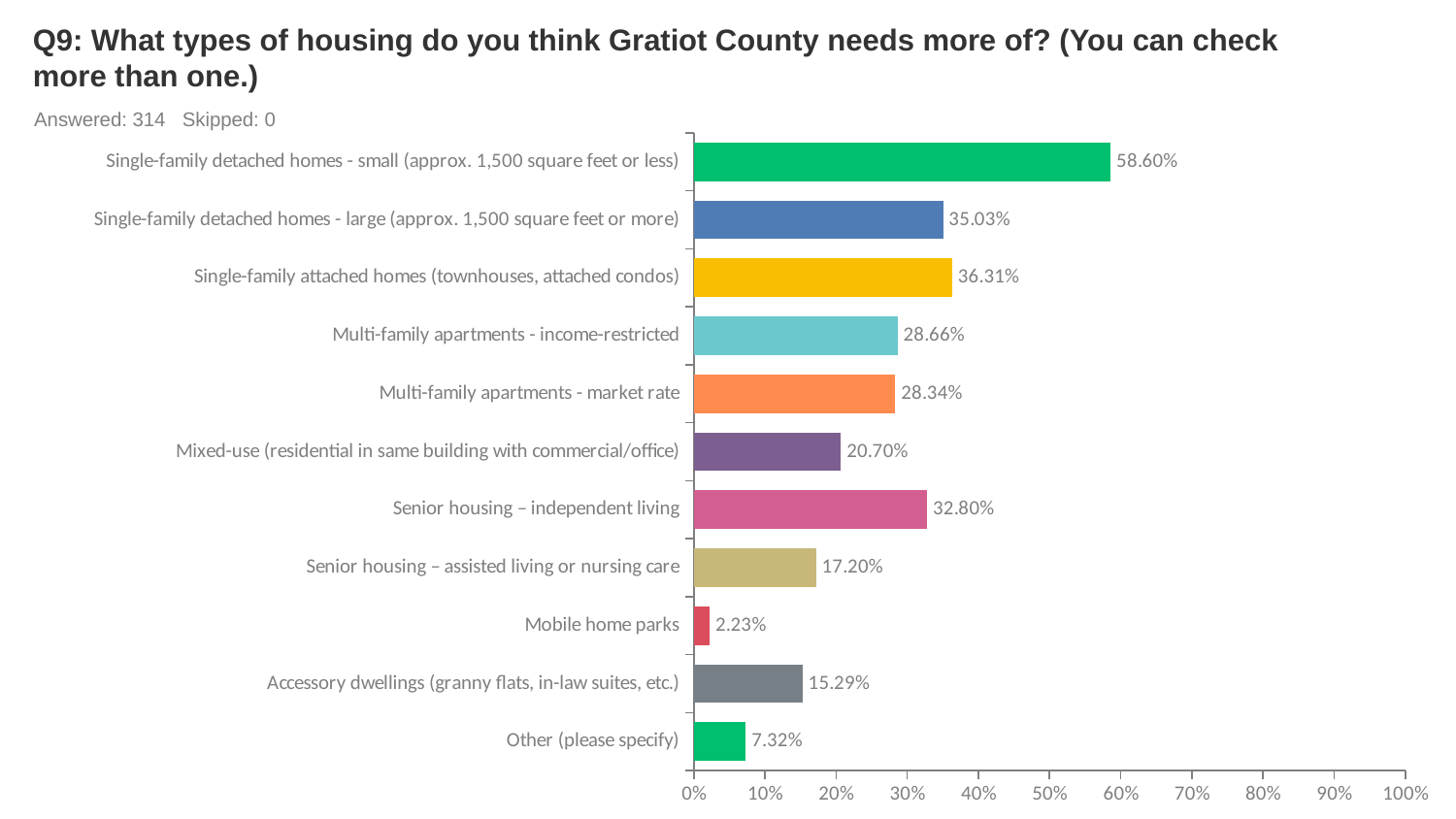
What is the difference between 'Multi-family apartments - income-restricted' and 'Multi-family apartments - market rate'? 0.32% Is the value for 'Mixed-use (residential in same building with commercial/office)' greater or less than 30%? less What percentage is shown for 'Senior housing – independent living'? 32.80% What kind of chart is shown on the slide? Bar chart What is the difference between 'Single-family attached homes (townhouses, attached condos)' and 'Single-family detached homes - large (approx. 1,500 square feet or more)'? 1.28% What percentage of respondents selected 'Single-family detached homes - small (approx. 1,500 square feet or less)'? 58.60% How many respondents answered this question? 314 Which housing type has the lowest percentage? Mobile home parks Which is larger: 'Senior housing – assisted living or nursing care' or 'Accessory dwellings (granny flats, in-law suites, etc.)'? Senior housing – assisted living or nursing care What is the value for 'Mobile home parks'? 2.23% How many housing type categories are shown in the chart? 11 Which housing type has the highest percentage? Single-family detached homes - small (approx. 1,500 square feet or less)